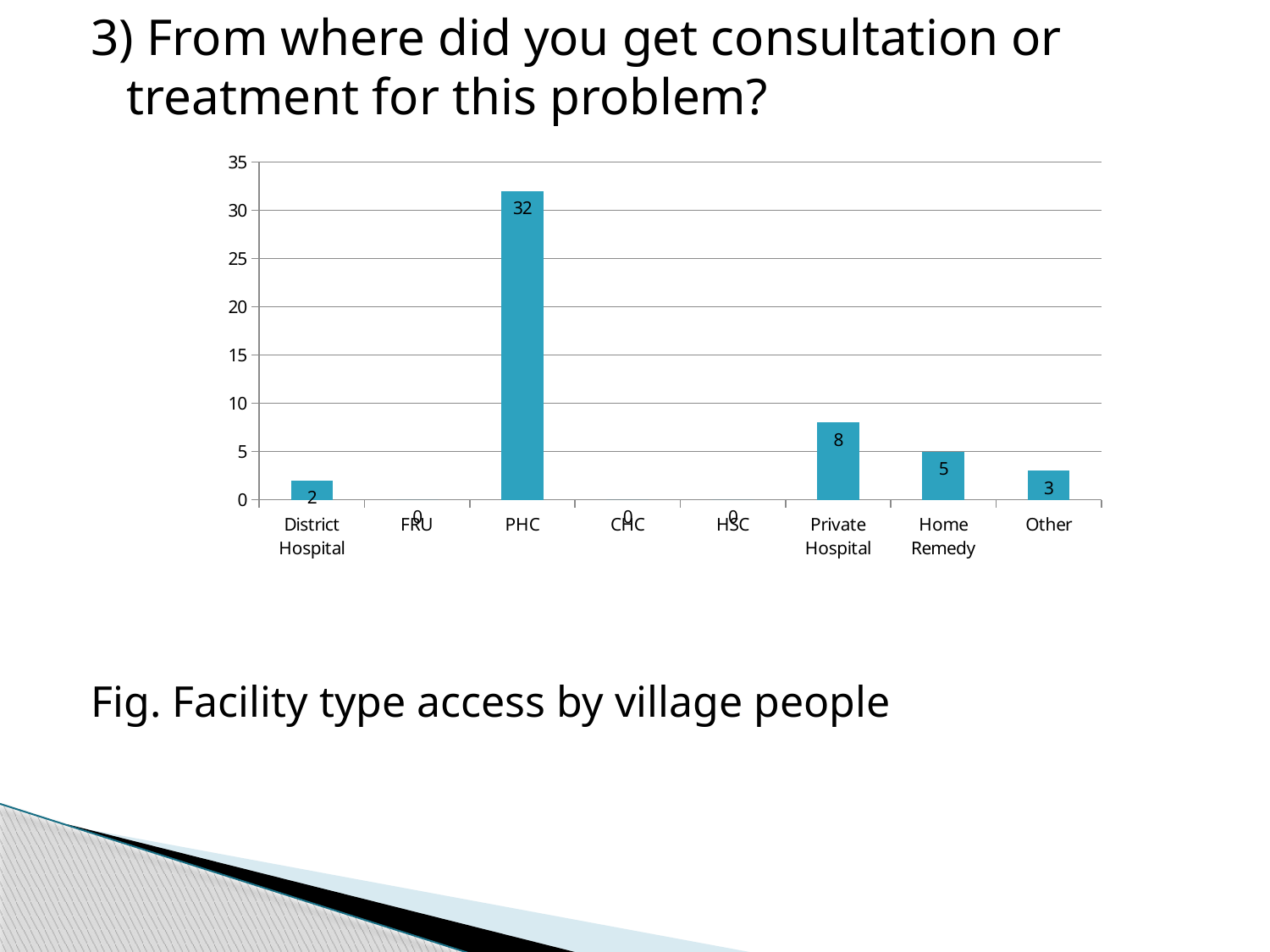
What is the value for Other? 3 What is the value for PHC? 32 What is the value for Private Hospital? 8 Which category has the highest value? PHC What is the value for District Hospital? 2 What is the difference between the values for PHC and Private Hospital? 24 Is the value for PHC greater or less than 30? greater What is the value for Home Remedy? 5 What kind of chart is shown on the slide? bar chart How many categories have a value of 0? 3 How many categories are shown on the x axis? 8 Which is larger, the value for Home Remedy or the value for Other? Home Remedy